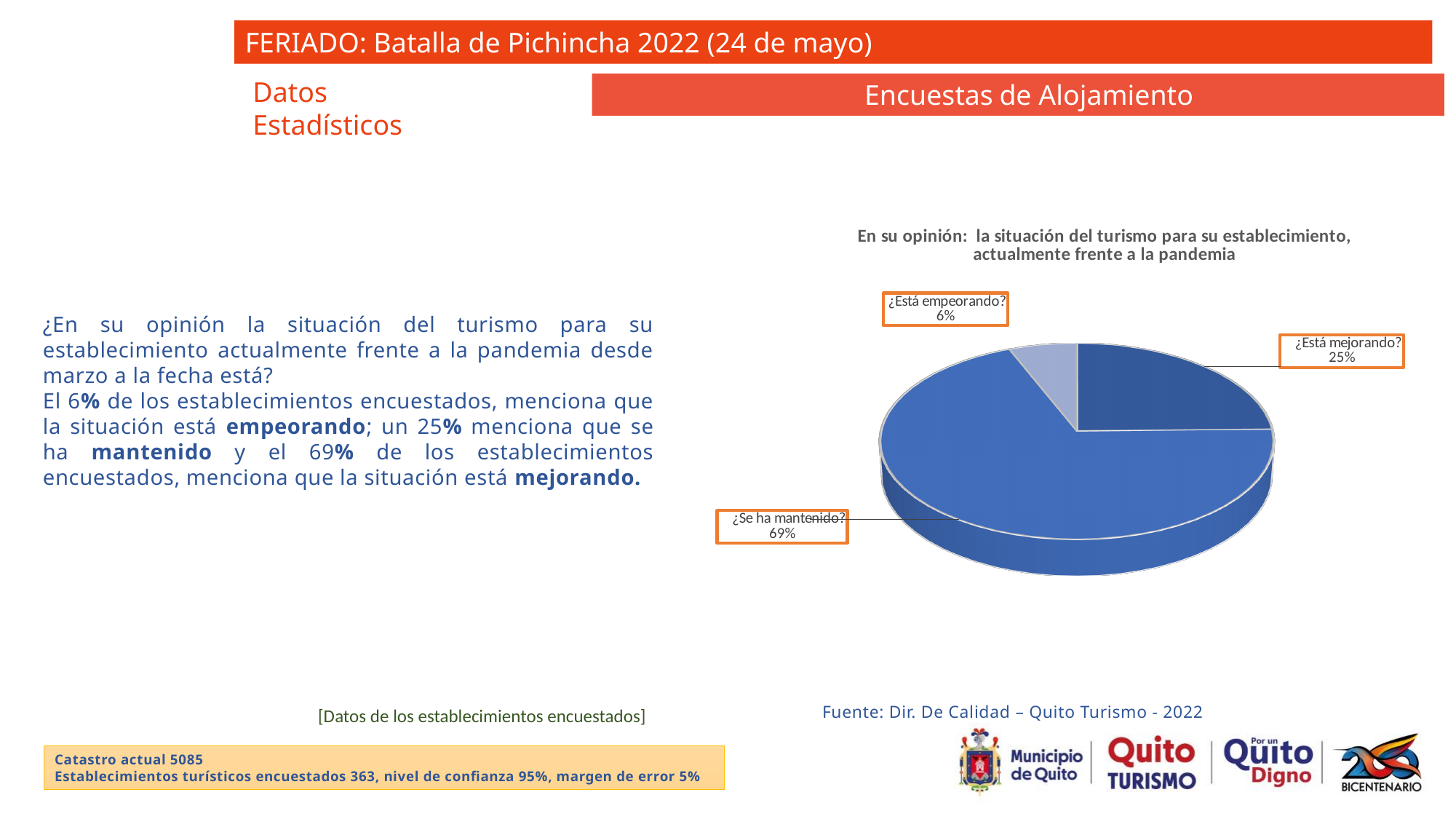
Which is larger, the "¿Está mejorando?" slice or the "¿Está empeorando?" slice? ¿Está mejorando? Which slice of the pie chart is the largest? ¿Se ha mantenido? What share of the pie does the "¿Está mejorando?" slice represent? 25% What percentage is shown for the slice labelled "¿Está empeorando?"? 6% What percentage is shown for the slice labelled "¿Está mejorando?"? 25% What is the difference in percentage points between the "¿Se ha mantenido?" slice and the "¿Está mejorando?" slice? 44 How many slices does the pie chart have? 3 What is the title of the pie chart? En su opinión: la situación del turismo para su establecimiento, actualmente frente a la pandemia What percentage is shown for the slice labelled "¿Se ha mantenido?"? 69% What is the difference in percentage points between the "¿Está mejorando?" slice and the "¿Está empeorando?" slice? 19 What kind of chart is shown on the slide? Pie chart Which slice of the pie chart is the smallest? ¿Está empeorando?